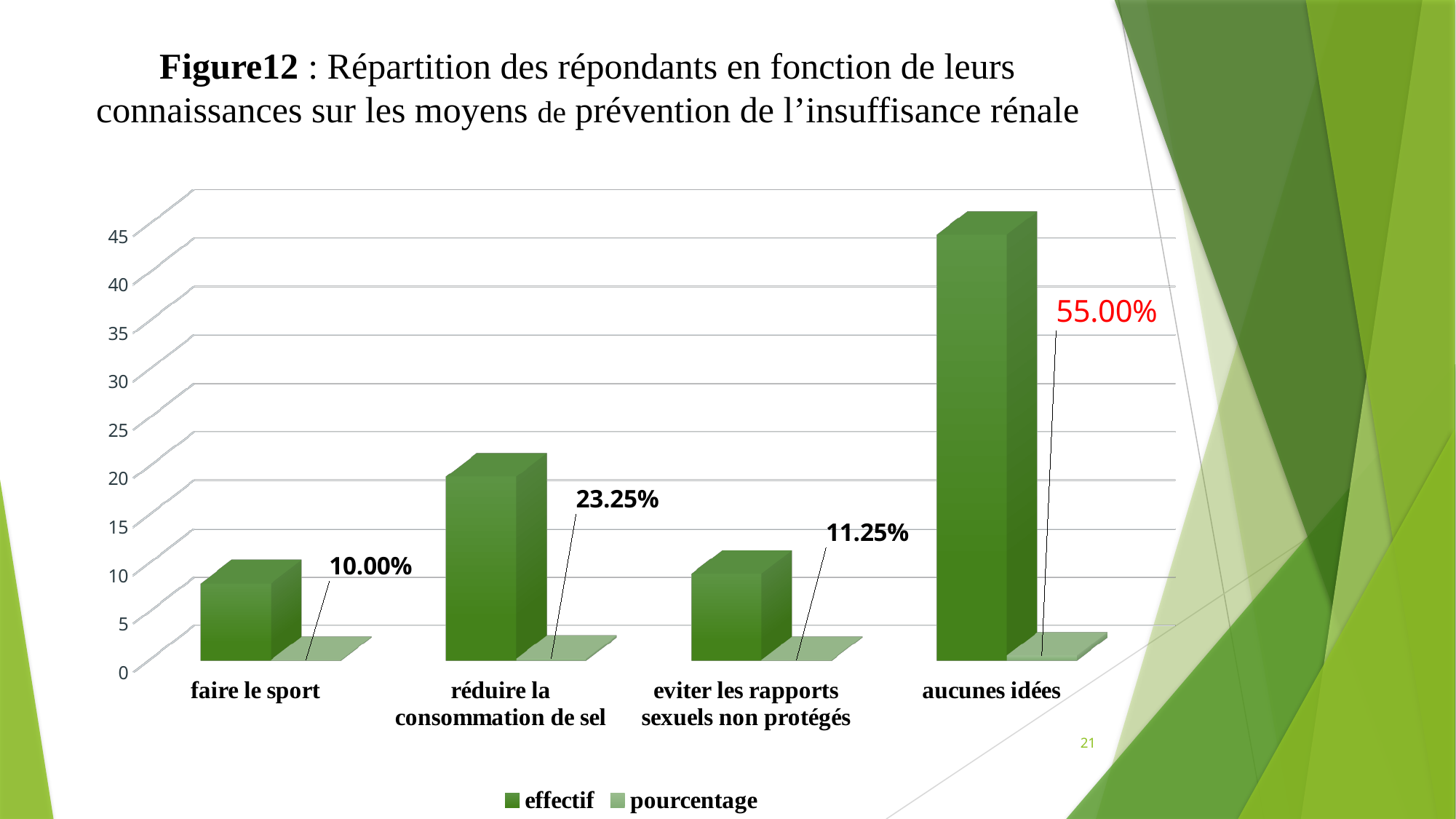
How many categories are shown on the x axis? 4 What is the difference in pourcentage between 'aucunes idées' and 'réduire la consommation de sel'? 31.75% Which category has the highest pourcentage? aucunes idées Is the effectif value for 'aucunes idées' greater or less than 40? greater What is the pourcentage value for 'réduire la consommation de sel'? 23.25% What is the pourcentage value for 'faire le sport'? 10.00% What is the pourcentage value for 'aucunes idées'? 55.00% How many series does the legend list? 2 Which has a larger effectif: 'réduire la consommation de sel' or 'eviter les rapports sexuels non protégés'? réduire la consommation de sel What is the pourcentage value for 'eviter les rapports sexuels non protégés'? 11.25% What kind of chart is shown on the slide? bar chart Which category has the lowest pourcentage? faire le sport